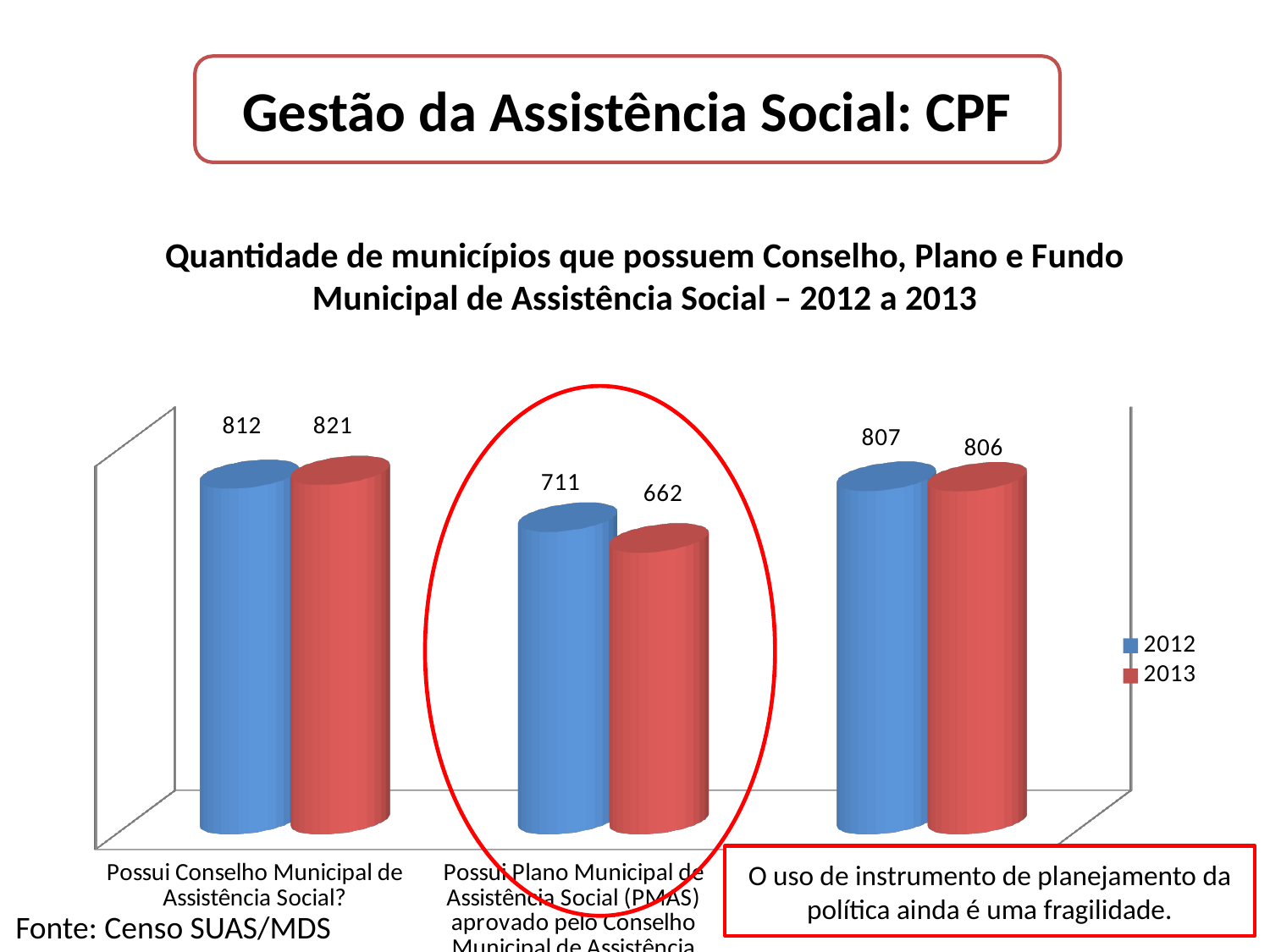
Which colour represents the 2013 series in the chart? Red What is the difference between the 2012 and 2013 values for 'Possui Plano Municipal de Assistência Social (PMAS) aprovado pelo Conselho'? 49 Which series has the lowest value in the chart? 2013 What is the 2013 value for 'Possui Plano Municipal de Assistência Social (PMAS) aprovado pelo Conselho'? 662 Which is larger for 'Possui Plano Municipal de Assistência Social (PMAS) aprovado pelo Conselho': the 2012 value or the 2013 value? 2012 What type of chart is shown on the slide? Bar chart What is the difference between the 2013 and 2012 values for 'Possui Conselho Municipal de Assistência Social?'? 9 What is the highest value shown in the chart? 821 How many series does the legend list? 2 What is the 2013 value for 'Possui Conselho Municipal de Assistência Social?'? 821 What is the 2012 value for 'Possui Conselho Municipal de Assistência Social?'? 812 What is the 2012 value for 'Possui Plano Municipal de Assistência Social (PMAS) aprovado pelo Conselho'? 711